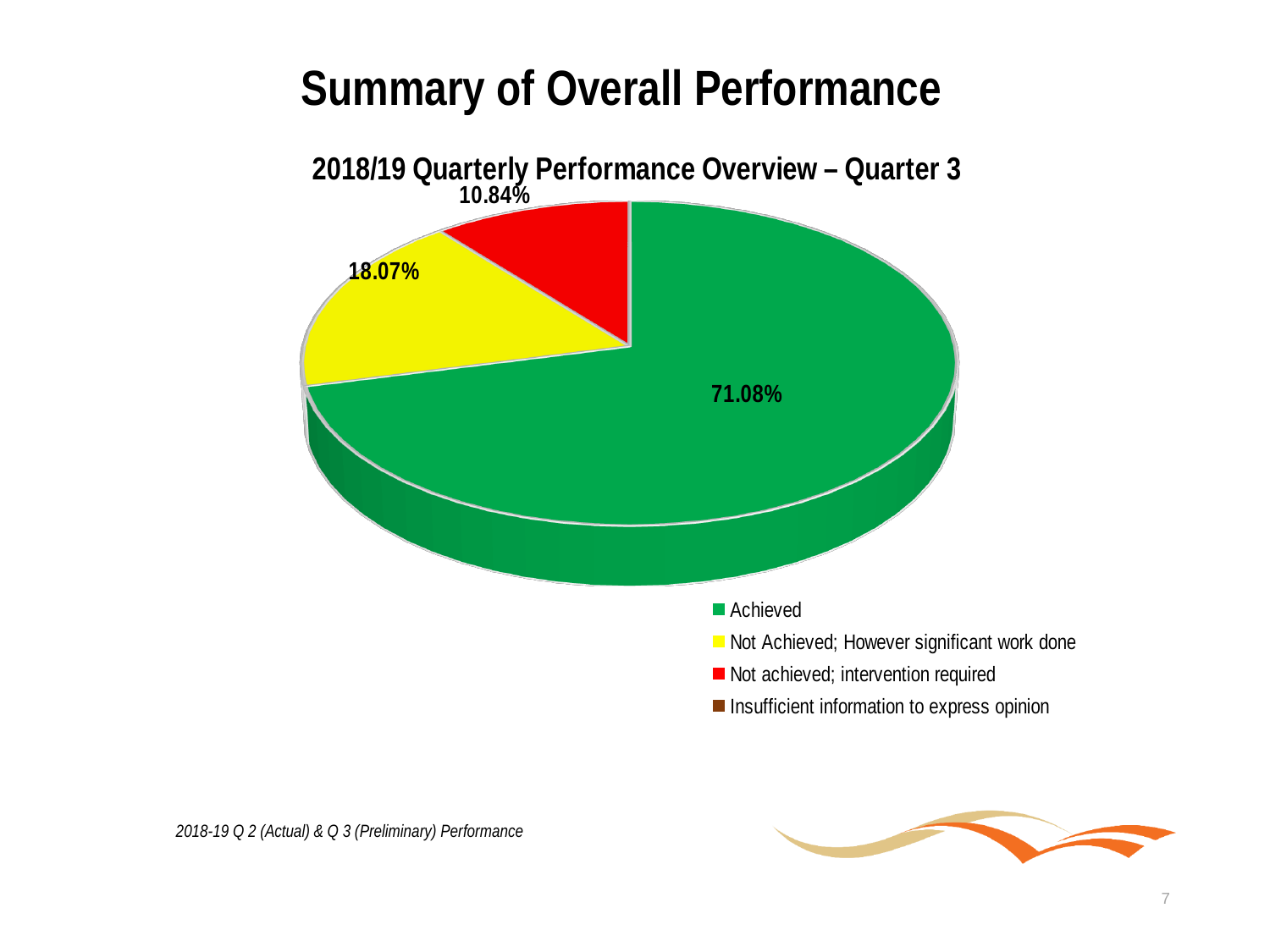
What colour is the Achieved slice? Green What kind of chart is shown on the slide? Pie chart Which of the visible slices is the smallest? Not achieved; intervention required What is the title of the chart? 2018/19 Quarterly Performance Overview – Quarter 3 Which category has the largest slice of the pie? Achieved What is the difference between the Achieved share and the Not Achieved; However significant work done share? 53.01% What share of the pie is labelled Not Achieved; However significant work done? 18.07% How many entries does the legend list? 4 What is the difference between the Not Achieved; However significant work done share and the Not achieved; intervention required share? 7.23% Which is larger: the Not Achieved; However significant work done slice or the Not achieved; intervention required slice? Not Achieved; However significant work done What share of the pie is labelled Achieved? 71.08% What share of the pie is labelled Not achieved; intervention required? 10.84%